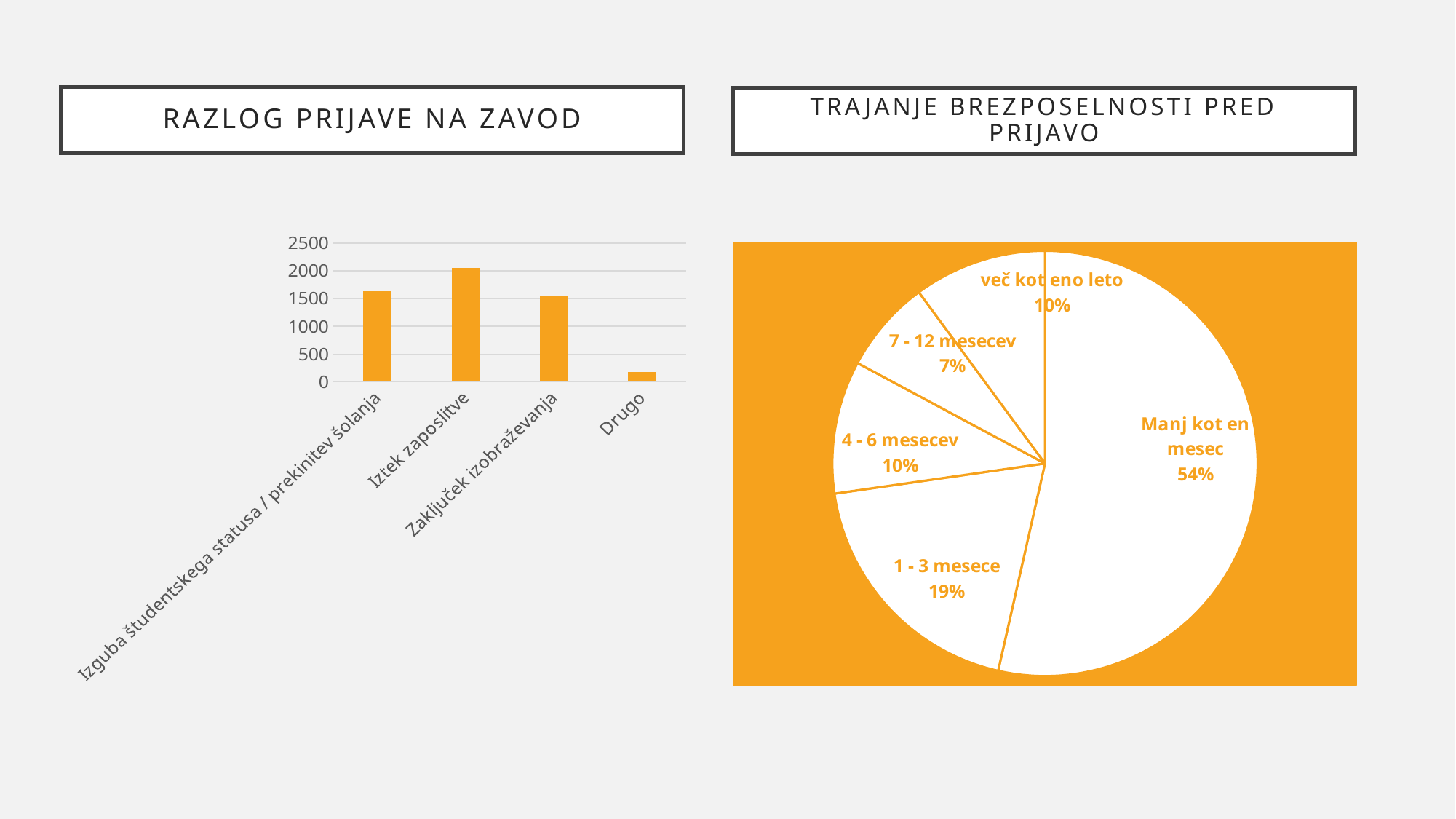
In the chart titled TRAJANJE BREZPOSELNOSTI PRED PRIJAVO, which slice is the smallest? 7 - 12 mesecev In the chart titled RAZLOG PRIJAVE NA ZAVOD, which category has the highest value? Iztek zaposlitve In the chart titled RAZLOG PRIJAVE NA ZAVOD, is the value for Drugo greater or less than 500? less What kind of chart is the chart titled TRAJANJE BREZPOSELNOSTI PRED PRIJAVO? pie chart In the chart titled RAZLOG PRIJAVE NA ZAVOD, is the value for Izguba študentskega statusa / prekinitev šolanja greater or less than 1500? greater In the chart titled RAZLOG PRIJAVE NA ZAVOD, how many categories are shown? 4 In the chart titled TRAJANJE BREZPOSELNOSTI PRED PRIJAVO, what share does Manj kot en mesec have? 54% In the chart titled TRAJANJE BREZPOSELNOSTI PRED PRIJAVO, what is the difference between Manj kot en mesec and 1 - 3 mesece? 35% In the chart titled RAZLOG PRIJAVE NA ZAVOD, which category has the lowest value? Drugo In the chart titled TRAJANJE BREZPOSELNOSTI PRED PRIJAVO, what is the value for 1 - 3 mesece? 19% What kind of chart is the chart titled RAZLOG PRIJAVE NA ZAVOD? bar chart In the chart titled RAZLOG PRIJAVE NA ZAVOD, which is larger: Iztek zaposlitve or Zaključek izobraževanja? Iztek zaposlitve